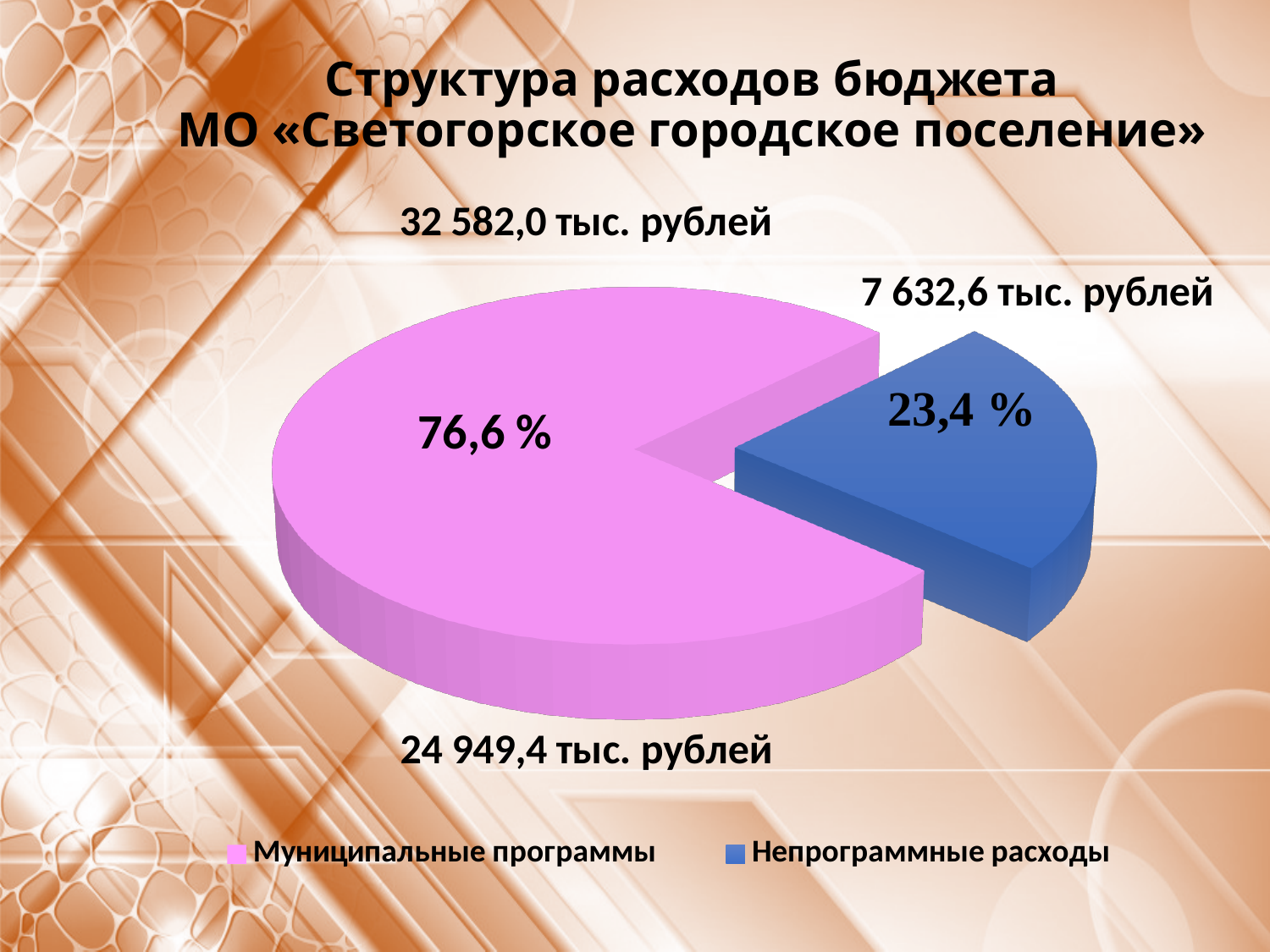
What is the value in тыс. рублей for Непрограммные расходы? 7 632,6 тыс. рублей Which slice is the largest? Муниципальные программы How many entries does the legend list? 2 How many slices does the pie chart have? 2 Which is larger, Муниципальные программы or Непрограммные расходы? Муниципальные программы What is the total of the two slices in тыс. рублей, as printed on the slide? 32 582,0 тыс. рублей What share of the pie is Непрограммные расходы? 23,4 % Which slice is the smallest? Непрограммные расходы What kind of chart is shown on the slide? pie chart What colour is the Непрограммные расходы slice? blue What is the value in тыс. рублей for Муниципальные программы? 24 949,4 тыс. рублей What share of the pie is Муниципальные программы? 76,6 %